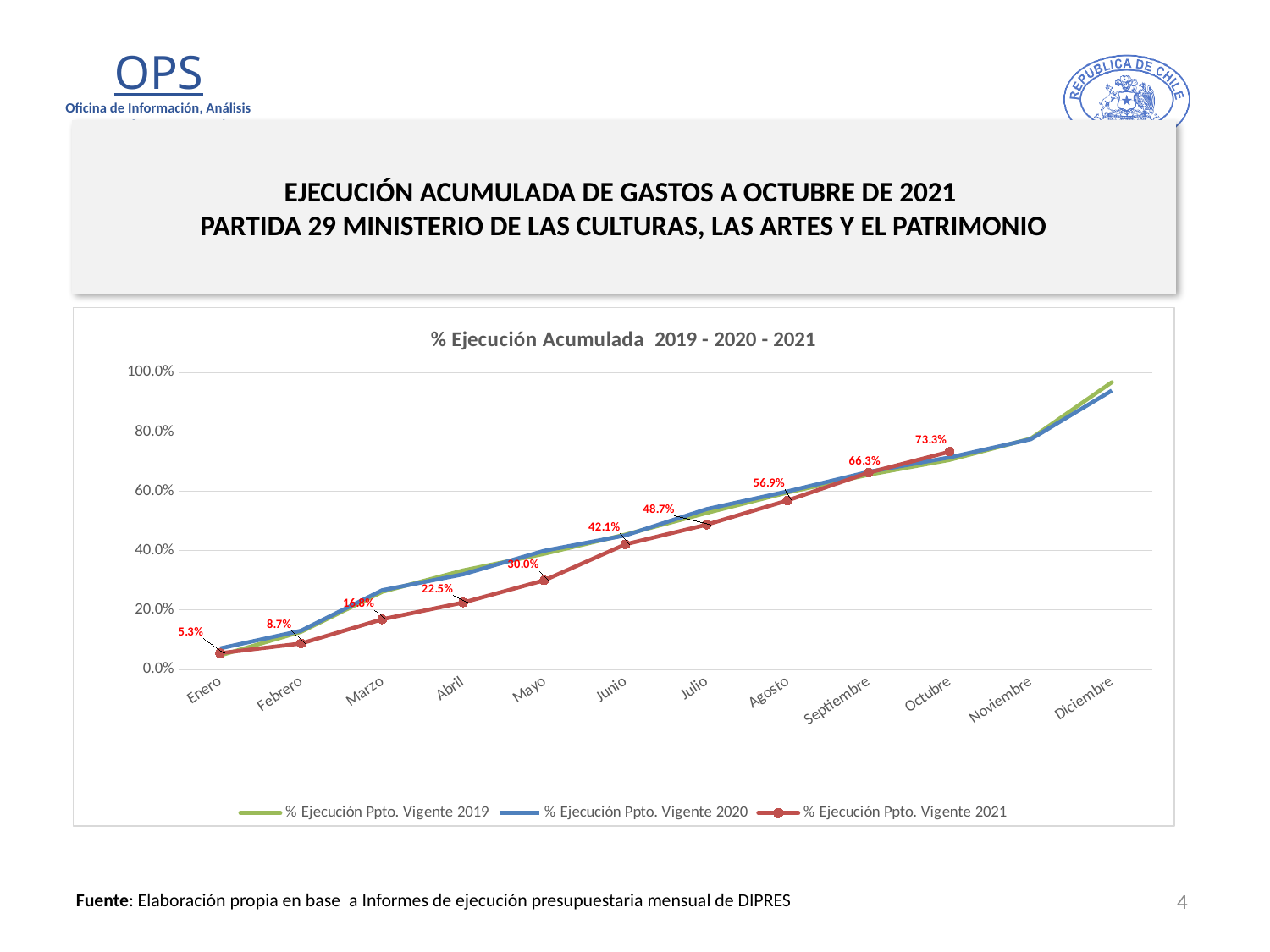
Which month has the lowest labelled value for the 2021 series? Enero Which is larger for the 2021 series: the value for Mayo or the value for Abril? Mayo What is the value of % Ejecución Ppto. Vigente 2021 for Junio? 42.1% What is the value of % Ejecución Ppto. Vigente 2021 for Agosto? 56.9% What is the value of % Ejecución Ppto. Vigente 2021 for Enero? 5.3% What is the value of % Ejecución Ppto. Vigente 2021 for Octubre? 73.3% Is the value of % Ejecución Ppto. Vigente 2020 for Diciembre greater or less than 80.0%? greater How many months are shown on the x axis? 12 What is the difference between the 2021 values for Octubre and Septiembre? 7.0% Which month has the highest labelled value for the 2021 series? Octubre What kind of chart is shown on the slide? Line chart How many series does the legend list? 3